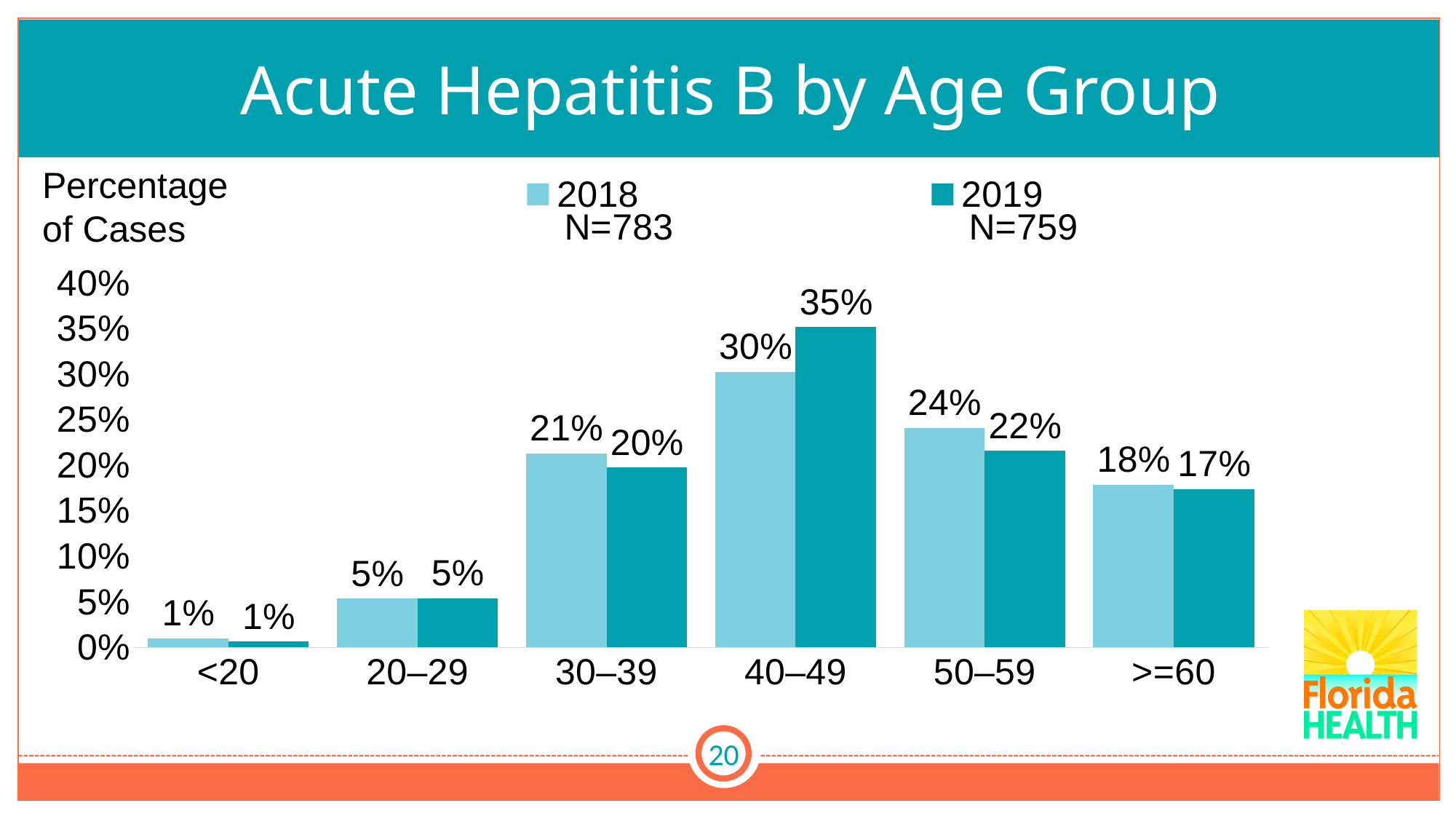
What is the difference between the 2018 and 2019 percentages for the 50–59 age group? 2% Which year had the larger percentage of cases in the 30–39 age group, 2018 or 2019? 2018 What kind of chart is shown on the slide? Bar chart What percentage of acute hepatitis B cases were in the 40–49 age group in 2019? 35% How many series does the legend list? 2 What percentage of cases were in the >=60 age group in 2019? 17% What is the N value shown for 2018 in the legend? N=783 Which age group had the highest percentage of cases in 2018? 40–49 What percentage of cases were in the 30–39 age group in 2018? 21% Which age group had the lowest percentage of cases in 2019? <20 How many age groups are shown on the x axis? 6 What is the difference between the 2019 and 2018 percentages for the 40–49 age group? 5%